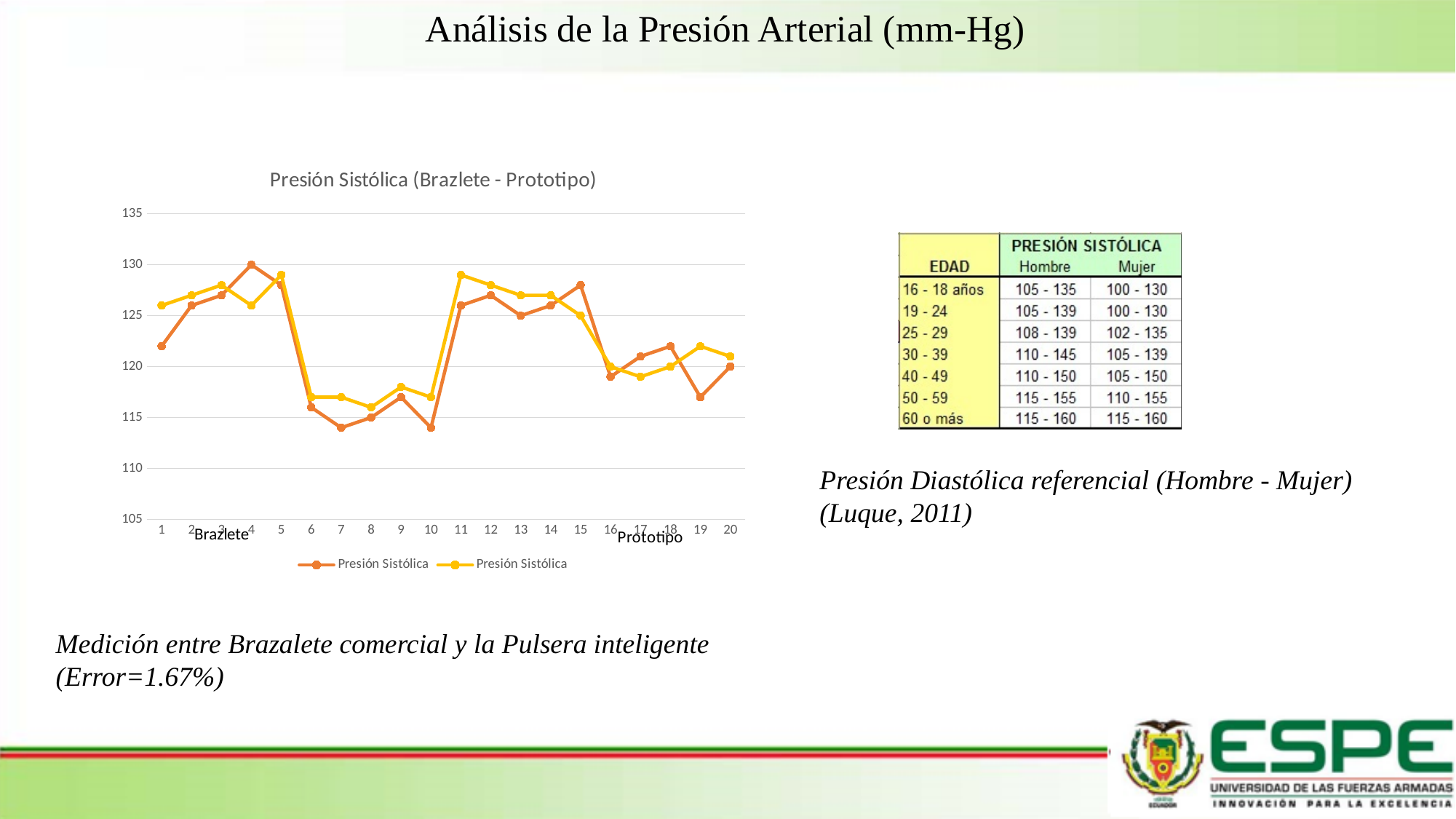
How many data points does each line in the chart have? 20 At point 19, which line has the larger value, the orange line or the yellow line? yellow line Is the value of the orange line at point 1 greater or less than 120? greater At point 1, which line has the larger value, the orange line or the yellow line? yellow line What is the title of the chart? Presión Sistólica (Brazlete - Prototipo) Is the value of the orange line at point 7 greater or less than 115? less What is the value of the orange line at point 4? 130 What kind of chart is shown on the slide? line chart How many series does the chart's legend list? 2 Does the orange line rise or fall from point 5 to point 6? fall Is the value of the yellow line at point 11 greater or less than 125? greater At which point does the orange line reach its highest value? 4